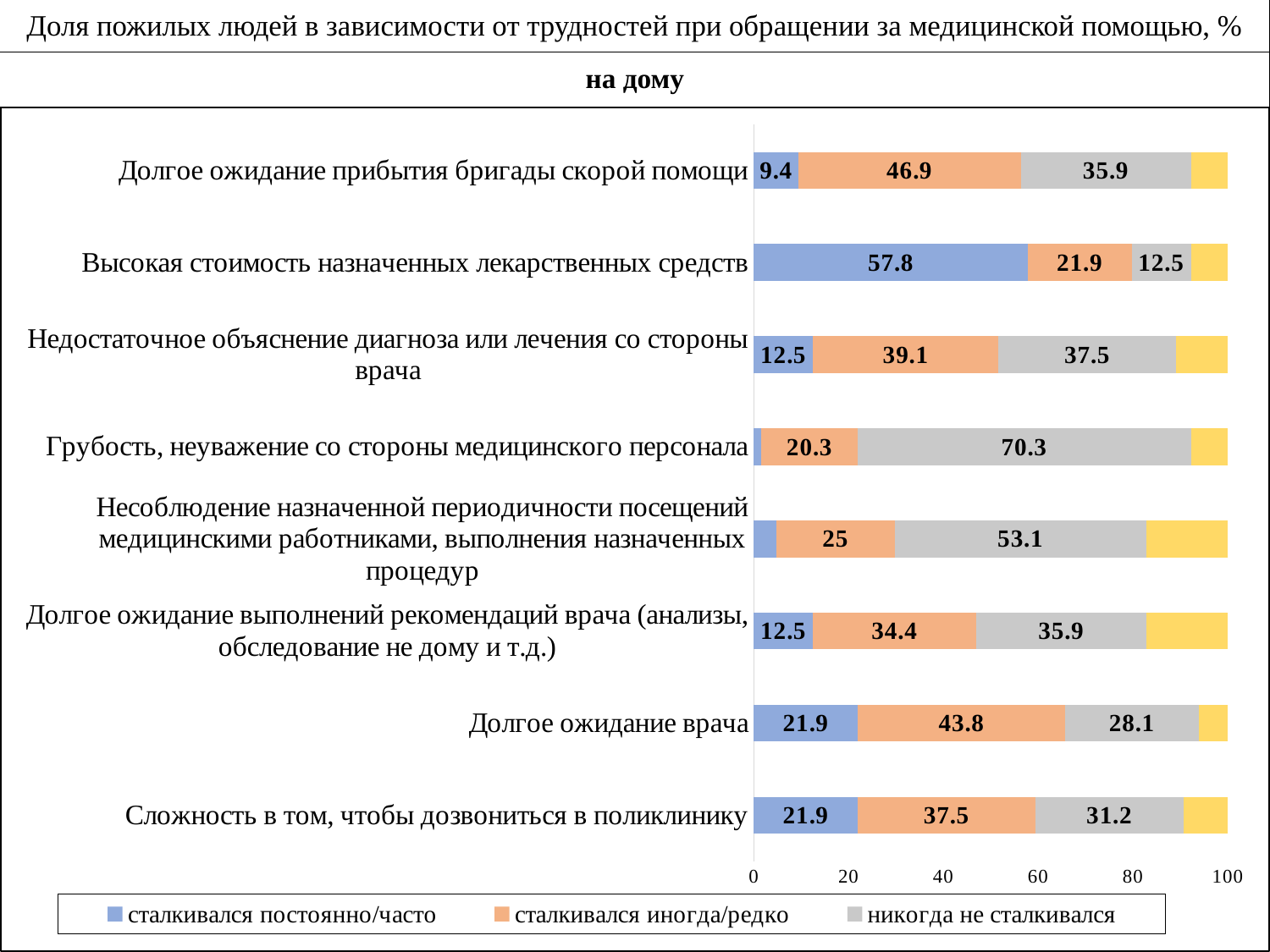
How many categories (difficulties) are listed on the chart? 8 What is the value of 'никогда не сталкивался' for 'Грубость, неуважение со стороны медицинского персонала'? 70.3 What is the value of 'сталкивался постоянно/часто' for 'Высокая стоимость назначенных лекарственных средств'? 57.8 Which has a larger 'сталкивался иногда/редко' value: 'Долгое ожидание врача' or 'Сложность в том, чтобы дозвониться в поликлинику'? Долгое ожидание врача What is the subtitle shown above the chart? на дому How many series does the legend list? 3 What is the difference between the 'сталкивался иногда/редко' and 'никогда не сталкивался' values for 'Долгое ожидание прибытия бригады скорой помощи'? 11 Which category has the highest value for 'сталкивался постоянно/часто'? Высокая стоимость назначенных лекарственных средств What is the value of 'сталкивался иногда/редко' for 'Долгое ожидание прибытия бригады скорой помощи'? 46.9 Is the 'сталкивался постоянно/часто' value for 'Высокая стоимость назначенных лекарственных средств' greater or less than 40? greater What type of chart is shown on the slide? Stacked bar chart Which category has the lowest value for 'никогда не сталкивался'? Высокая стоимость назначенных лекарственных средств